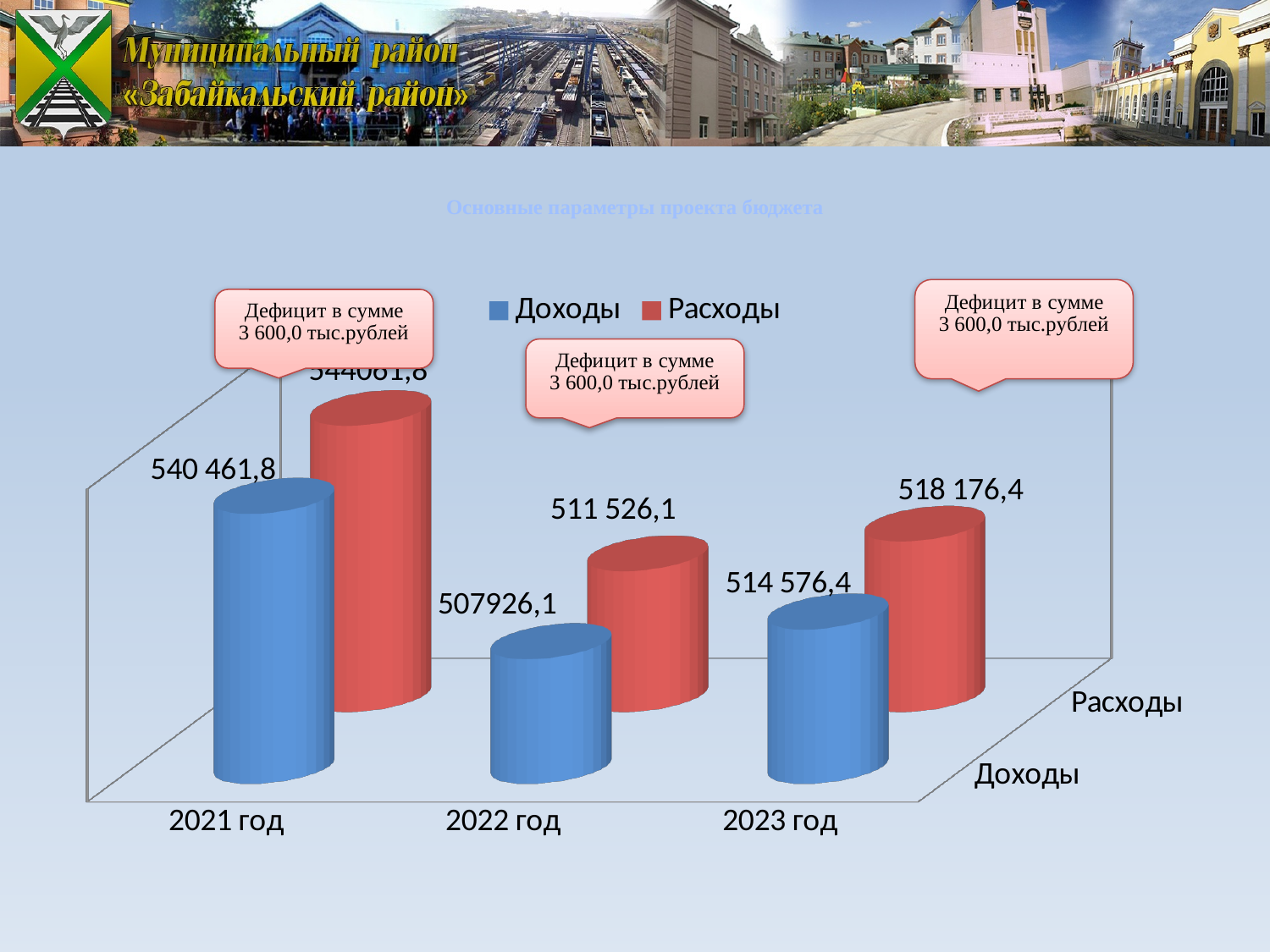
What is the difference between Доходы in 2021 год and Доходы in 2023 год? 25 885,4 By how much do Расходы exceed Доходы in 2023 год? 3 600,0 How many years are shown on the x axis of the chart? 3 What is the value of Доходы for 2022 год? 507926,1 In which year are Доходы the lowest? 2022 год In which year are Доходы the highest? 2021 год How many series does the legend list? 2 What is the value of Расходы for 2023 год? 518 176,4 What is the value of Расходы for 2022 год? 511 526,1 What is the value of Доходы for 2021 год? 540 461,8 What is the value of Доходы for 2023 год? 514 576,4 In 2022 год, which is larger: Доходы or Расходы? Расходы